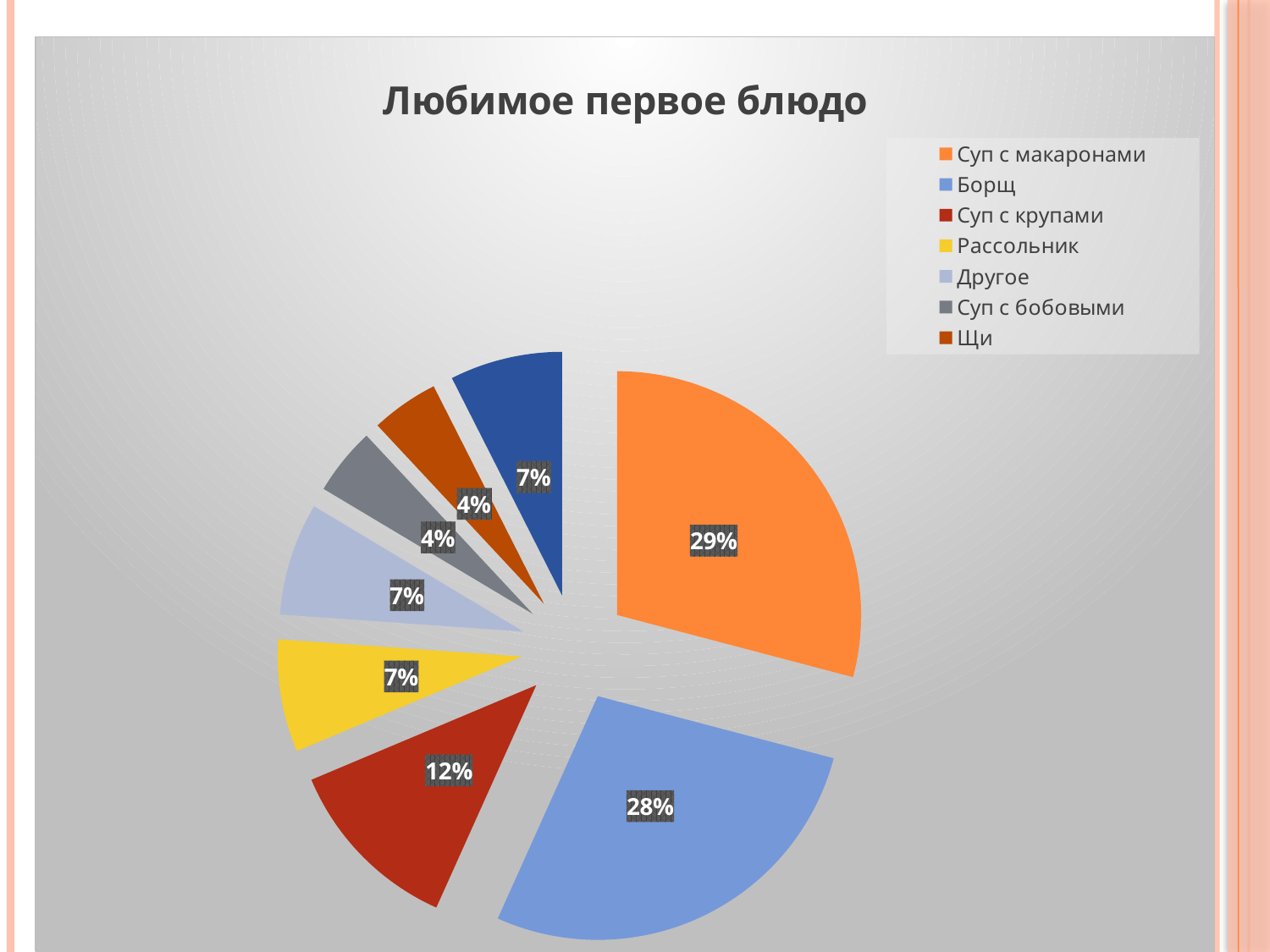
Which category has the largest share of the pie? Суп с макаронами What is the difference between the shares of Суп с макаронами and Борщ? 1% How many entries does the legend list? 7 Which has a larger share, Борщ or Суп с крупами? Борщ What kind of chart is shown on the slide? pie chart What share of the pie does Суп с крупами have? 12% What is the title of the chart? Любимое первое блюдо What share of the pie does Щи have? 4% What is the difference between the shares of Суп с крупами and Рассольник? 5% What share of the pie does Суп с макаронами have? 29% What share of the pie does Рассольник have? 7% What share of the pie does Борщ have? 28%